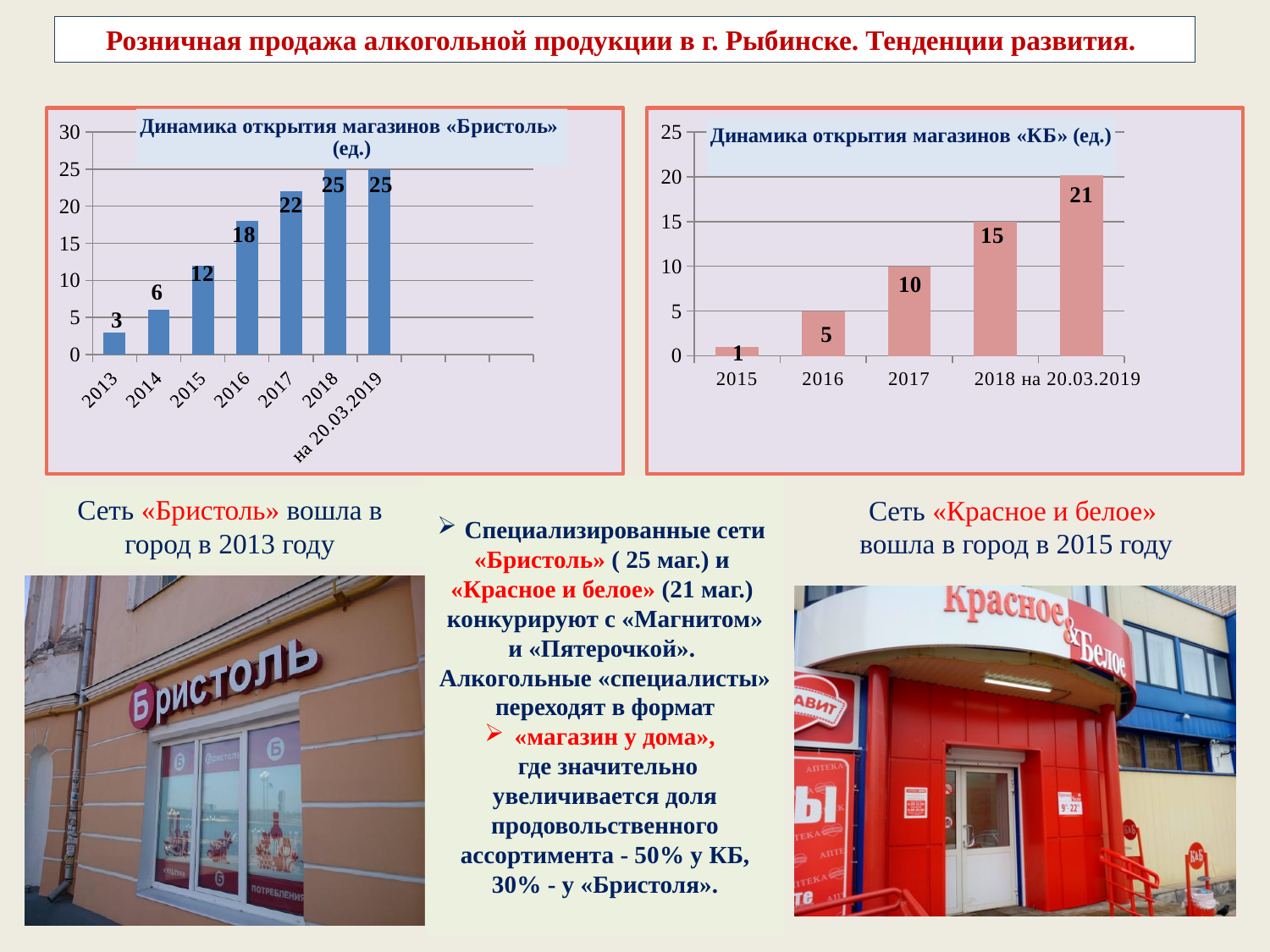
In the chart «Динамика открытия магазинов «КБ» (ед.)», what is the value for «на 20.03.2019»? 21 In the chart «Динамика открытия магазинов «КБ» (ед.)», what is the difference between the values for 2018 and 2016? 10 In the chart «Динамика открытия магазинов «Бристоль» (ед.)», what is the value for 2015? 12 How many categories are shown in the chart «Динамика открытия магазинов «Бристоль» (ед.)»? 7 In the chart «Динамика открытия магазинов «КБ» (ед.)», which category has the lowest value? 2015 In the chart «Динамика открытия магазинов «Бристоль» (ед.)», which category has the lowest value? 2013 In the chart «Динамика открытия магазинов «КБ» (ед.)», what is the value for 2017? 10 In the chart «Динамика открытия магазинов «Бристоль» (ед.)», what is the difference between the values for 2017 and 2016? 4 What kind of chart is «Динамика открытия магазинов «КБ» (ед.)»? Bar chart In the chart «Динамика открытия магазинов «Бристоль» (ед.)», which is larger: the value for 2014 or the value for 2016? 2016 How many categories are shown in the chart «Динамика открытия магазинов «КБ» (ед.)»? 5 In the chart «Динамика открытия магазинов «Бристоль» (ед.)», what is the value for 2013? 3